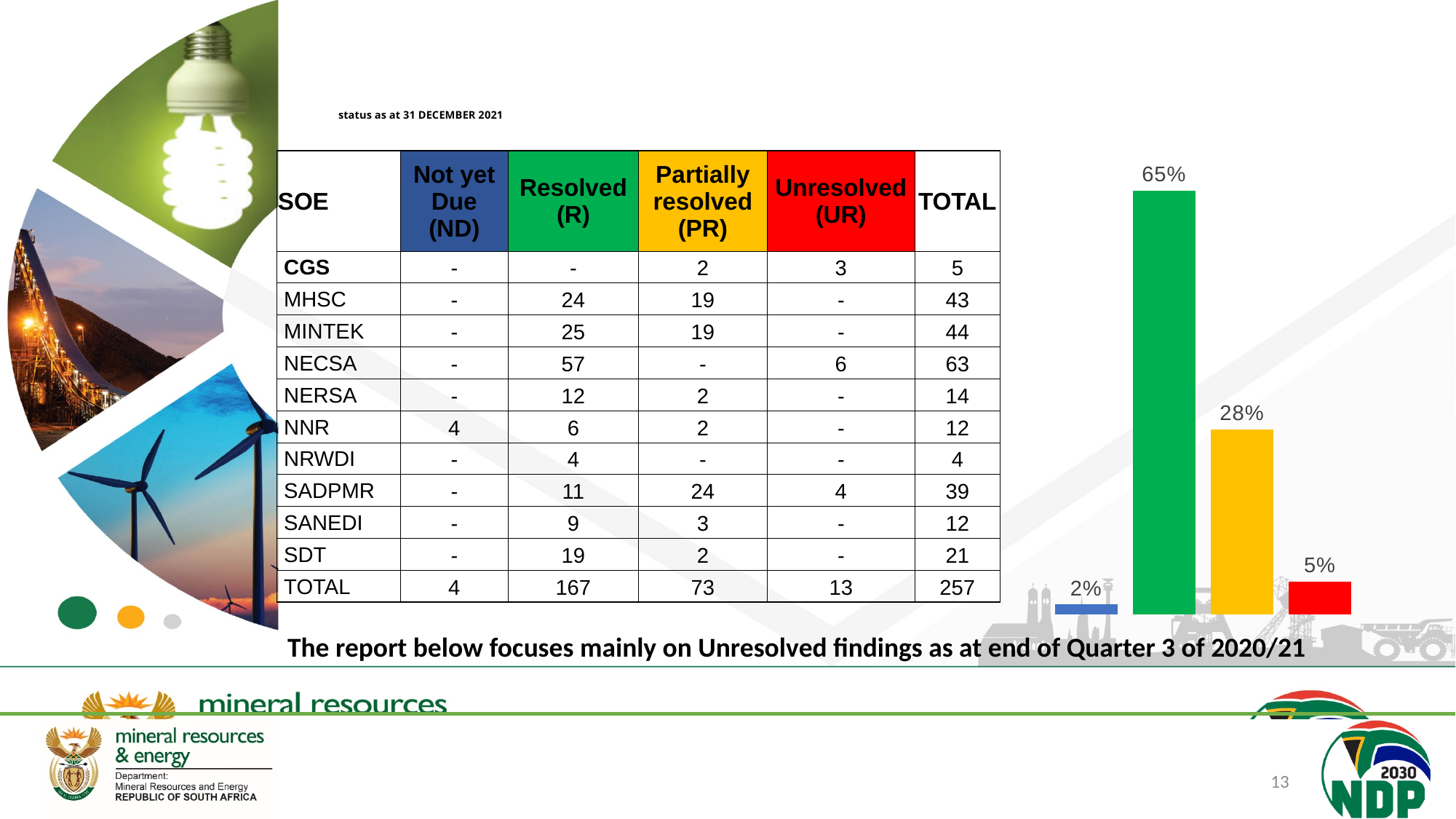
Which colour bar in the chart has the highest value? green What value is labelled on the red bar in the chart? 5% How many bars does the chart on the right of the slide have? 4 Which is larger in the chart, the red bar's value or the blue bar's value? red bar What is the difference between the green bar's value and the yellow bar's value in the chart? 37% What value is labelled on the green bar in the chart? 65% What value is labelled on the blue bar in the chart? 2% Which table column header shares the colour of the tallest bar in the chart? Resolved (R) What type of chart is shown on the right of the slide? bar chart What value is labelled on the yellow bar in the chart? 28% What is the difference between the red bar's value and the blue bar's value in the chart? 3% Which colour bar in the chart has the lowest value? blue